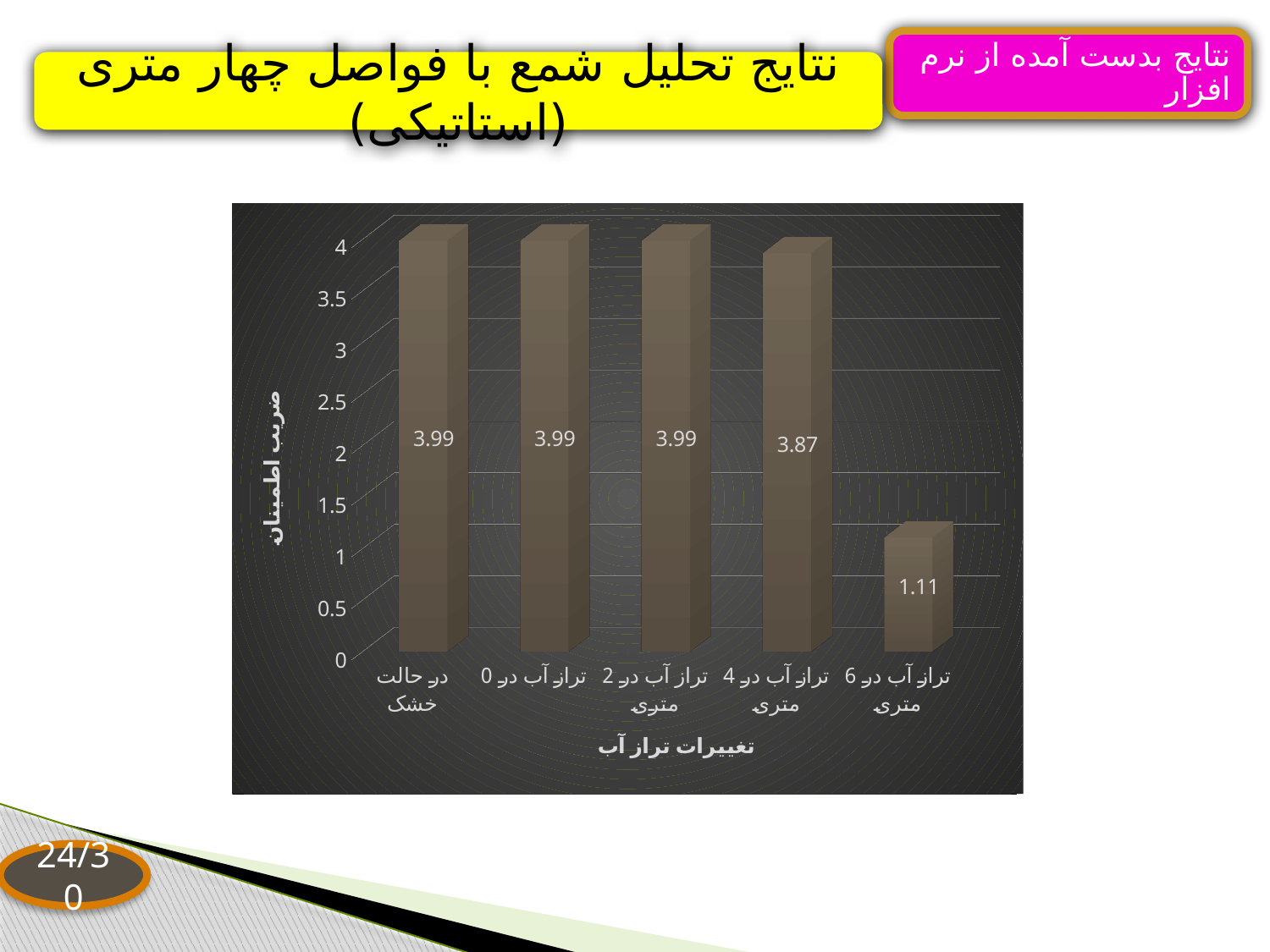
What is the difference between the values for 'تراز آب در 4 متری' and 'تراز آب در 6 متری'? 2.76 What kind of chart is shown on the slide? bar chart What is the value for 'تراز آب در 4 متری'? 3.87 What is the value for 'تراز آب در 2 متری'? 3.99 What is the label of the vertical axis? ضریب اطمینان Is the value for 'تراز آب در 6 متری' greater or less than 1.5? less Which category has the lowest value? تراز آب در 6 متری What is the value for the 'در حالت خشک' category? 3.99 Which is larger, the value for 'تراز آب در 2 متری' or 'تراز آب در 4 متری'? تراز آب در 2 متری What is the difference between the values for 'تراز آب در 0 متری' and 'تراز آب در 4 متری'? 0.12 What is the value for 'تراز آب در 6 متری'? 1.11 How many categories are shown on the x axis? 5